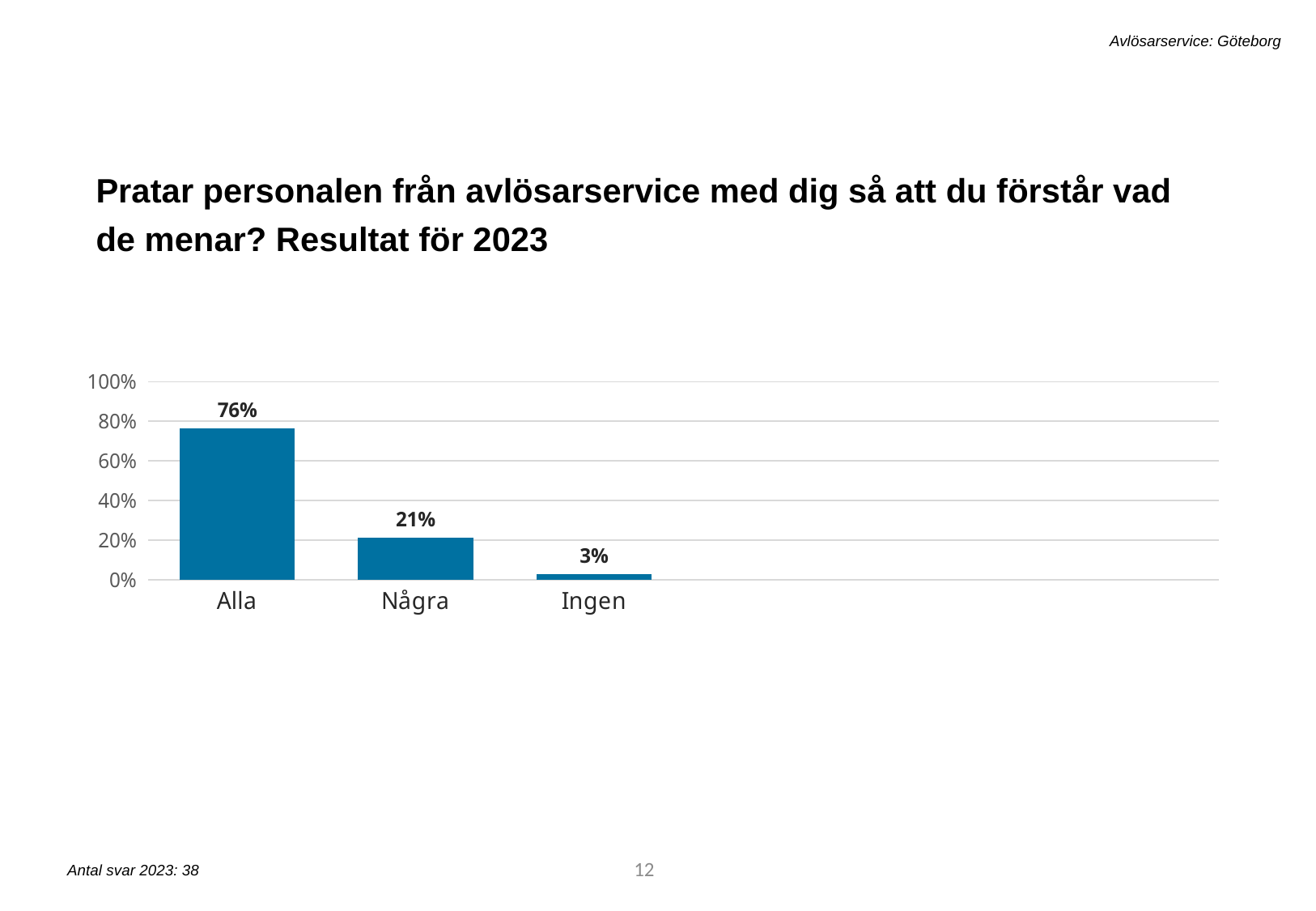
What kind of chart is shown on the slide? bar chart Do the values rise or fall from left to right along the x axis? fall Which category has the highest value? Alla Which is larger, the value for Några or the value for Ingen? Några What is the difference between the values for Alla and Några? 55% What is the value for Några? 21% What is the value for Ingen? 3% How many categories are shown on the x axis? 3 Is the value for Alla greater or less than 60%? greater Which category has the lowest value? Ingen What is the difference between the values for Några and Ingen? 18% What is the value for Alla? 76%